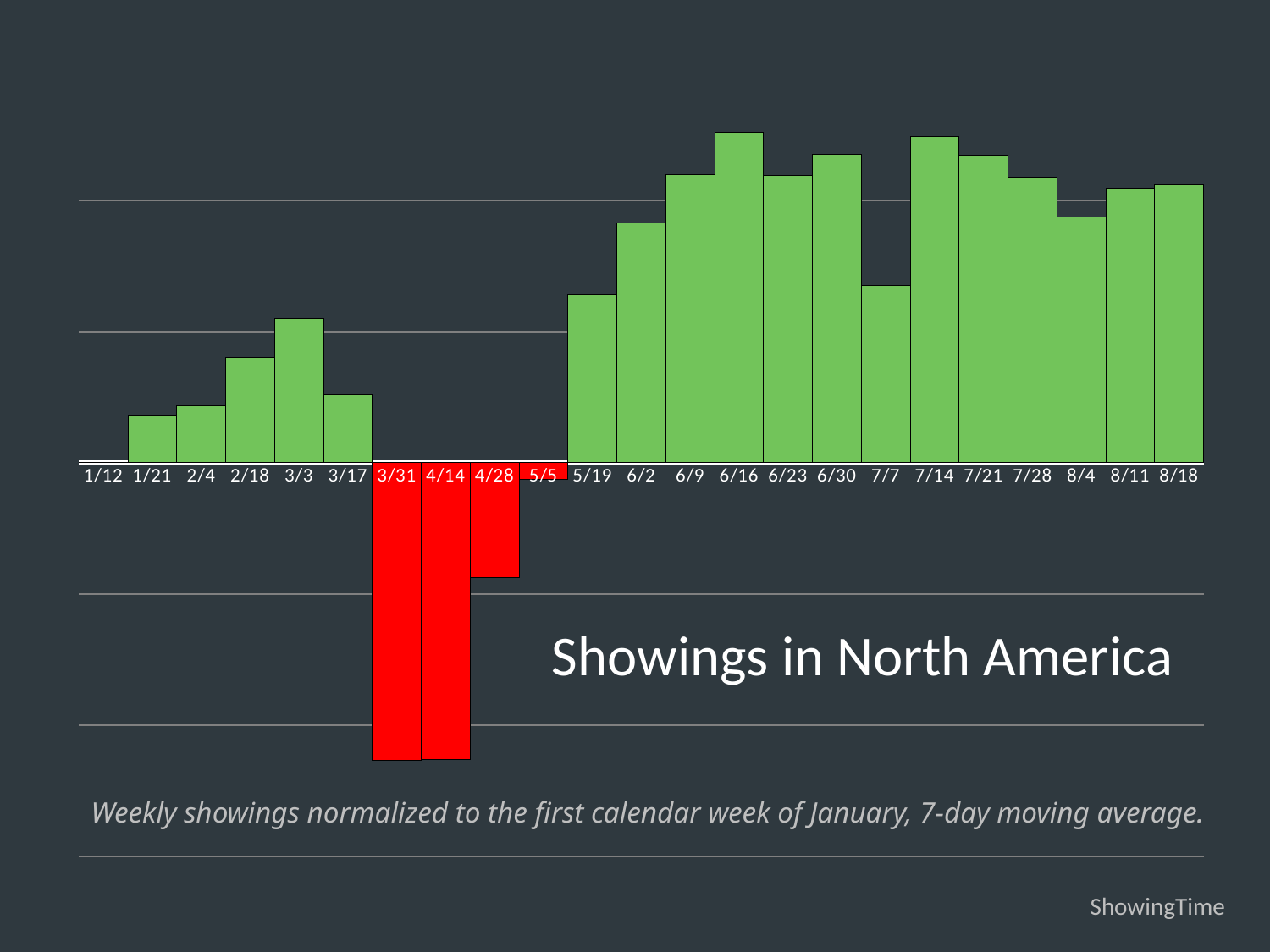
Do the values rise or fall from 5/19 to 6/16? rise Which is larger, the value for 3/3 or the value for 3/17? 3/3 What is the title of the chart? Showings in North America What kind of chart is shown on the slide? bar chart Which is larger, the value for 1/12 or the value for 1/21? 1/21 How many bars are shown in red (negative values)? 4 Which week is the first to show a negative value? 3/31 How many weekly categories are shown on the x axis? 23 Which is larger, the value for 5/19 or the value for 6/2? 6/2 Do the values rise or fall from 1/12 to 3/3? rise